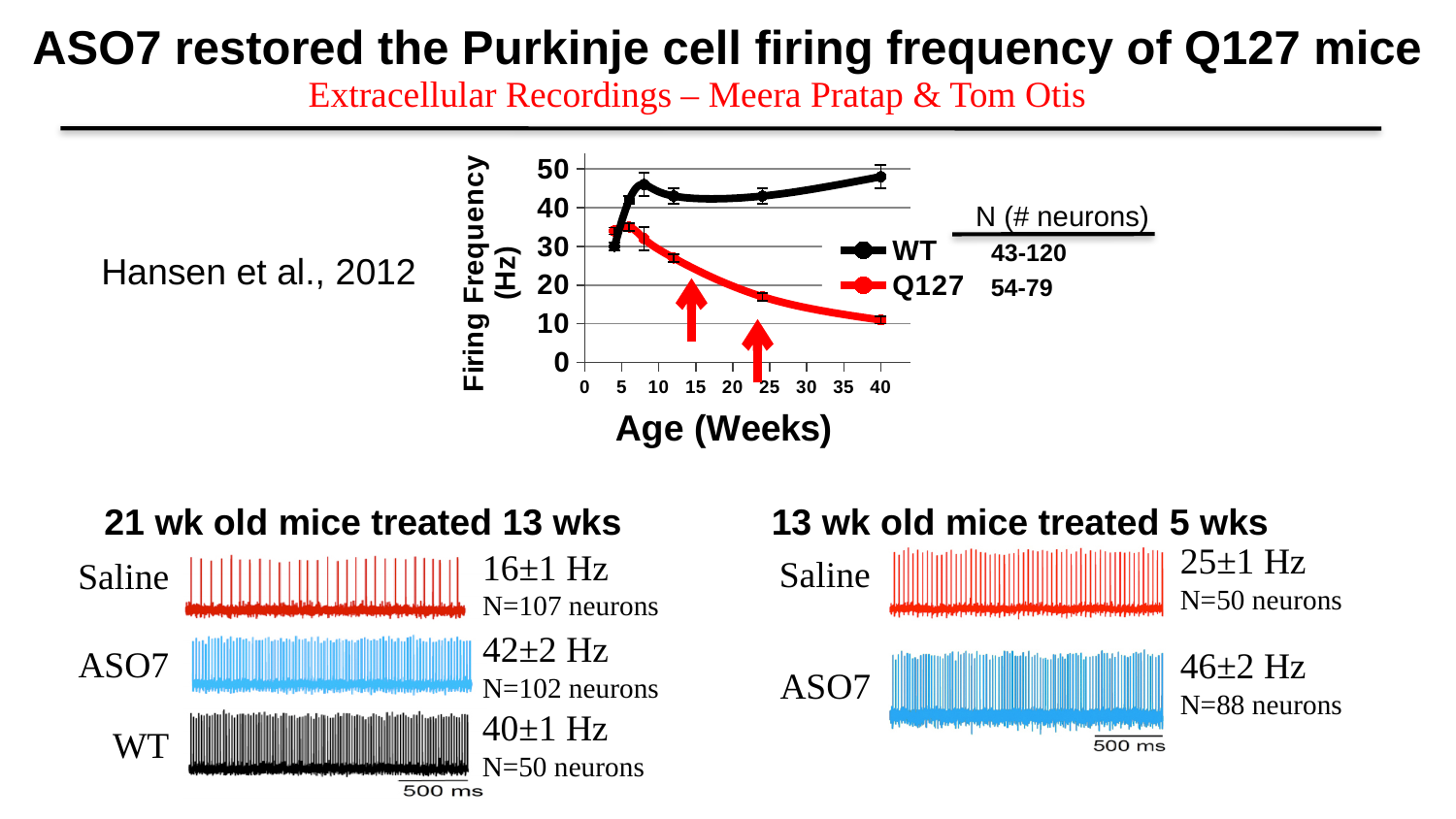
At 40 weeks, which series has the higher firing frequency, WT or Q127? WT Is the firing frequency for Q127 at 40 weeks greater or less than 20 Hz? less What kind of chart is shown on the slide? line chart What is the label of the chart's x axis? Age (Weeks) Is the firing frequency for WT at 40 weeks greater or less than 40 Hz? greater Is the firing frequency for WT at about 8 weeks greater or less than 40 Hz? greater Does the firing frequency of the Q127 series rise or fall as age increases from 5 to 40 weeks? fall What are the two series named in the chart's legend? WT and Q127 At which age does the Q127 series reach its lowest firing frequency? 40 weeks How many series does the chart's legend list? 2